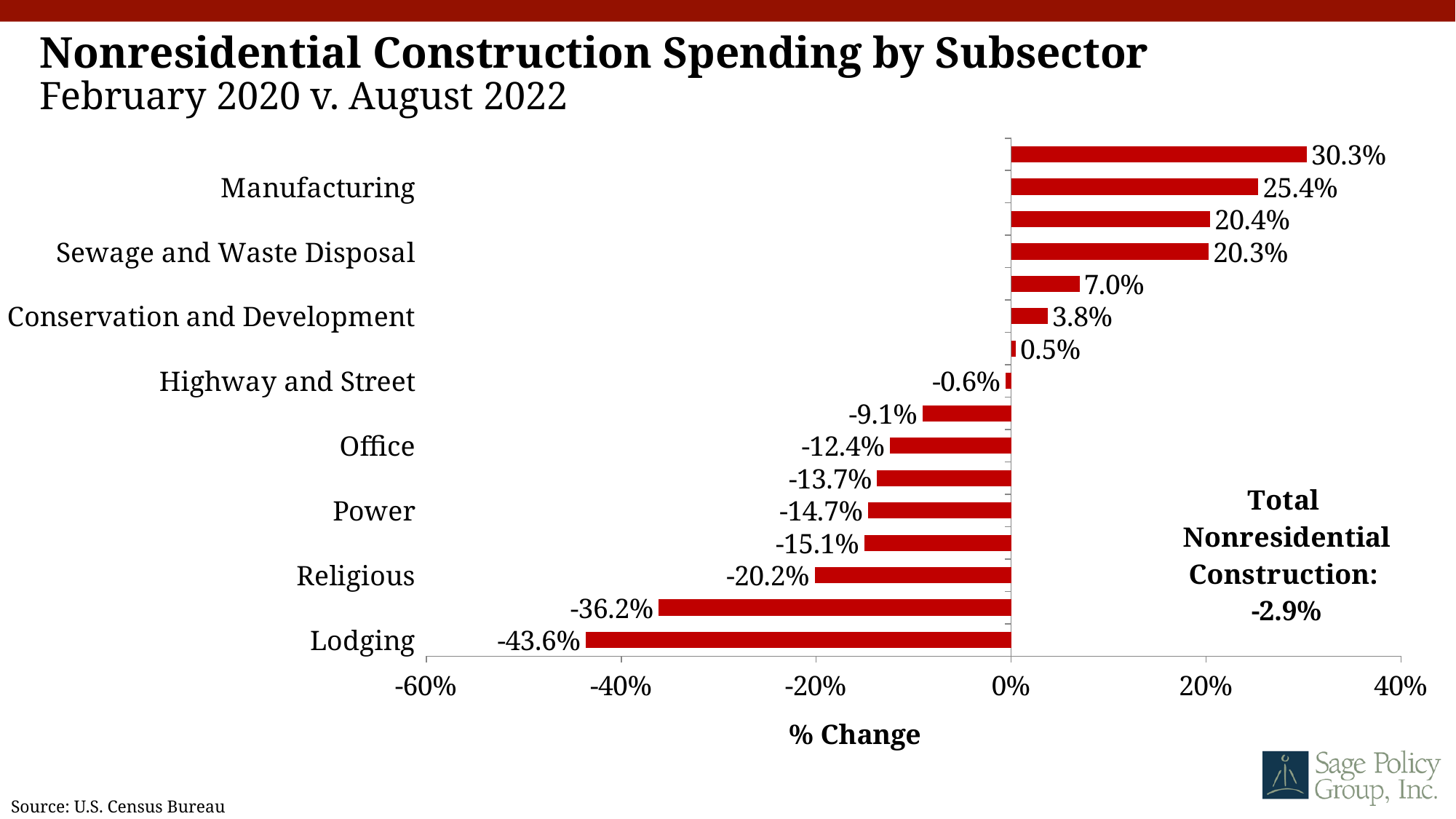
What is the percent change for Manufacturing? 25.4% Which labeled subsector has the lowest percent change? Lodging What is the percent change for Sewage and Waste Disposal? 20.3% What is the percent change for total nonresidential construction noted on the chart? -2.9% How many bars are plotted on the chart? 16 Is the value for Religious greater or less than -20%? less What is the percent change for Highway and Street? -0.6% What is the percent change for Lodging? -43.6% What kind of chart is shown on the slide? Bar chart Which has a larger percent change, Office or Power? Office What is the difference between the percent change for Manufacturing and for Sewage and Waste Disposal? 5.1 percentage points What is the largest percent change shown on the chart? 30.3%